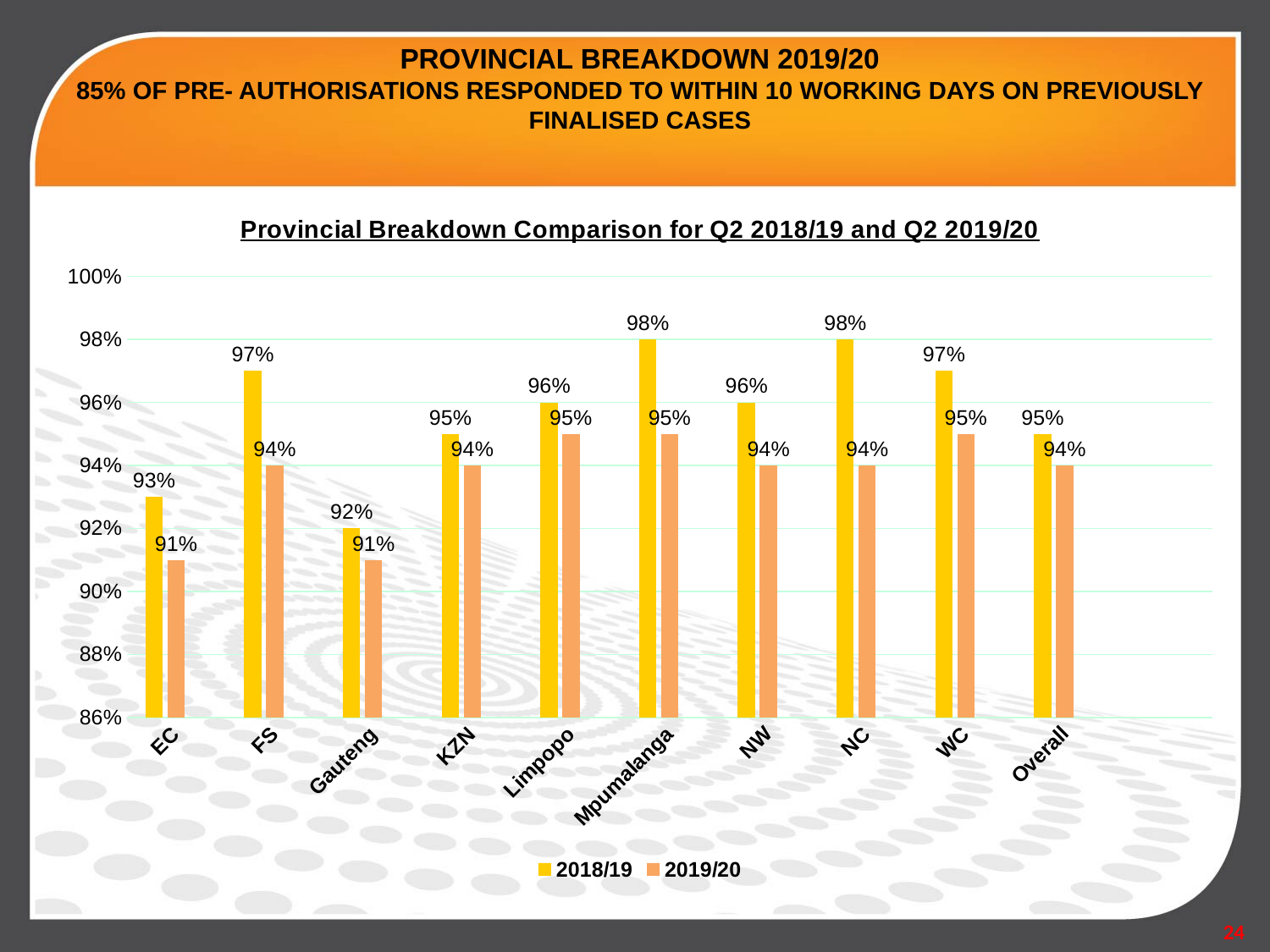
What is the difference between the 2018/19 and 2019/20 values for NC? 4 percentage points What is the 2019/20 value for EC? 91% What is the 2018/19 value for Mpumalanga? 98% What is the title of the chart? Provincial Breakdown Comparison for Q2 2018/19 and Q2 2019/20 What is the 2018/19 value for WC? 97% What is the difference between the 2018/19 and 2019/20 values for FS? 3 percentage points What kind of chart is shown on the slide? Bar chart How many categories are shown on the x axis? 10 For EC, which series has the larger value, 2018/19 or 2019/20? 2018/19 What is the 2019/20 value for Overall? 94% Which category has the lowest 2018/19 value? Gauteng How many series does the legend list? 2